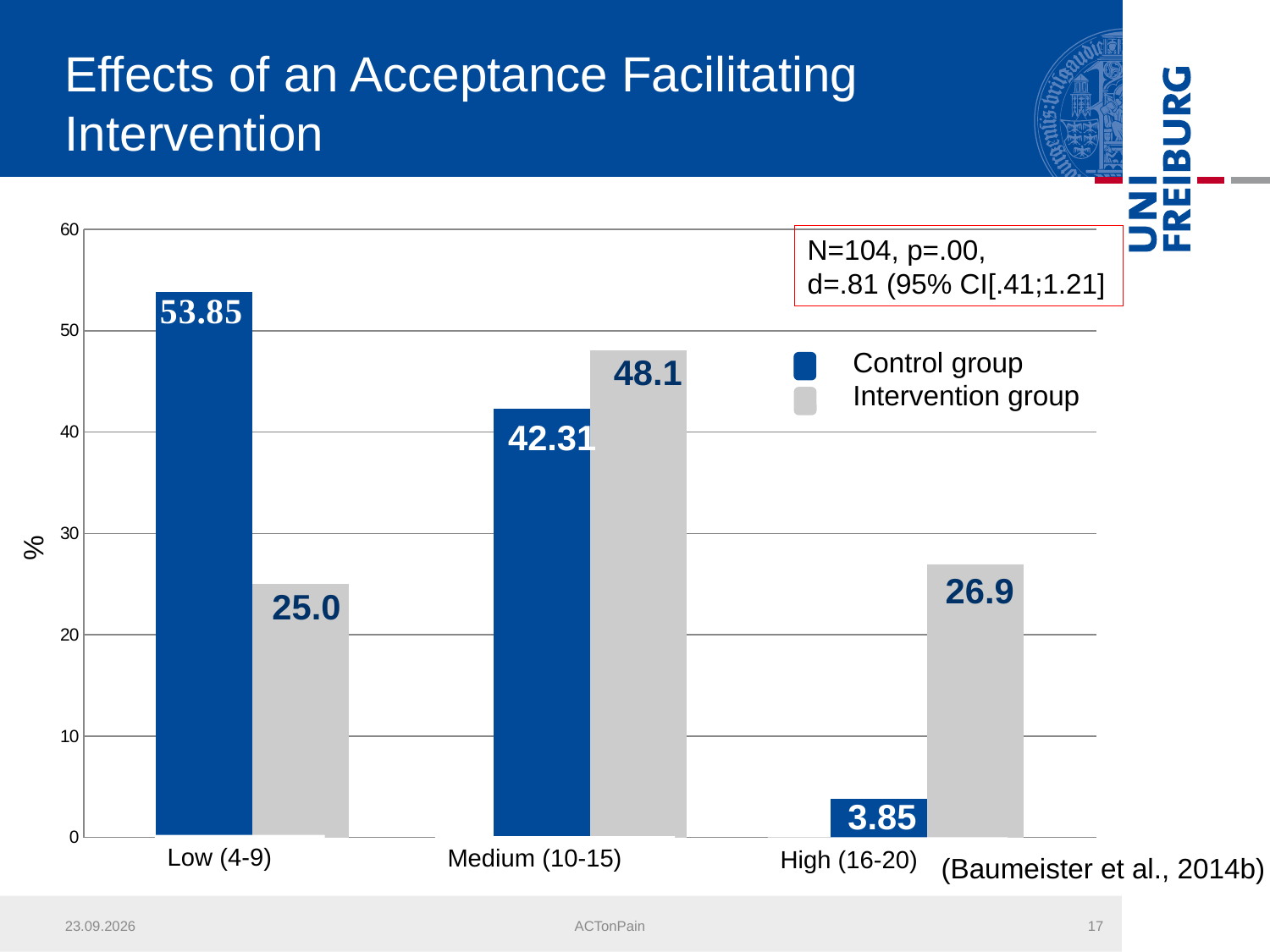
Which category has the lowest value for the Control group? High (16-20) What is the value for the Intervention group in the Medium (10-15) category? 48.1 How many categories are shown on the x axis? 3 Which category has the highest value for the Intervention group? Medium (10-15) Do the Control group values rise or fall from Low (4-9) to High (16-20)? Fall What is the label on the y axis? % In the Medium (10-15) category, which group has the larger value? Intervention group How many series does the legend list? 2 What is the value for the Control group in the Low (4-9) category? 53.85 What is the value for the Intervention group in the High (16-20) category? 26.9 What is the difference between the Control group and Intervention group values in the Low (4-9) category? 28.85 What kind of chart is shown on the slide? Bar chart